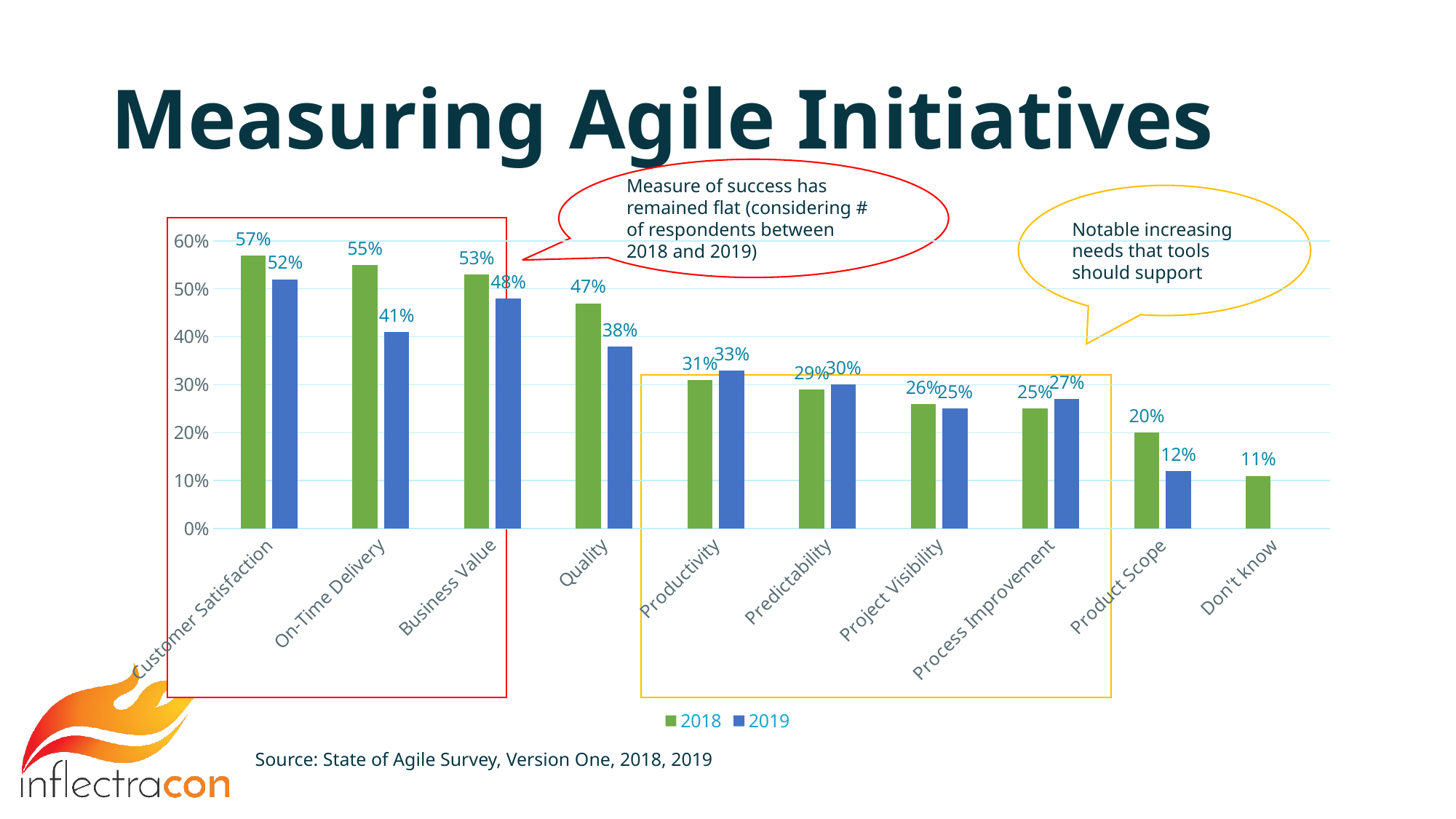
What is the 2018 value for Customer Satisfaction? 57% Which category has the highest 2018 value? Customer Satisfaction Which is larger for Process Improvement, the 2018 value or the 2019 value? 2019 What is the 2019 value for On-Time Delivery? 41% What is the 2018 value for Product Scope? 20% How many series does the legend list? 2 How many categories are shown on the x axis? 10 What is the 2019 value for Productivity? 33% Which category has the lowest 2019 value? Product Scope What is the difference between the 2018 and 2019 values for On-Time Delivery? 14% What kind of chart is shown on the slide? Bar chart Which colour represents the 2019 series in the legend? Blue